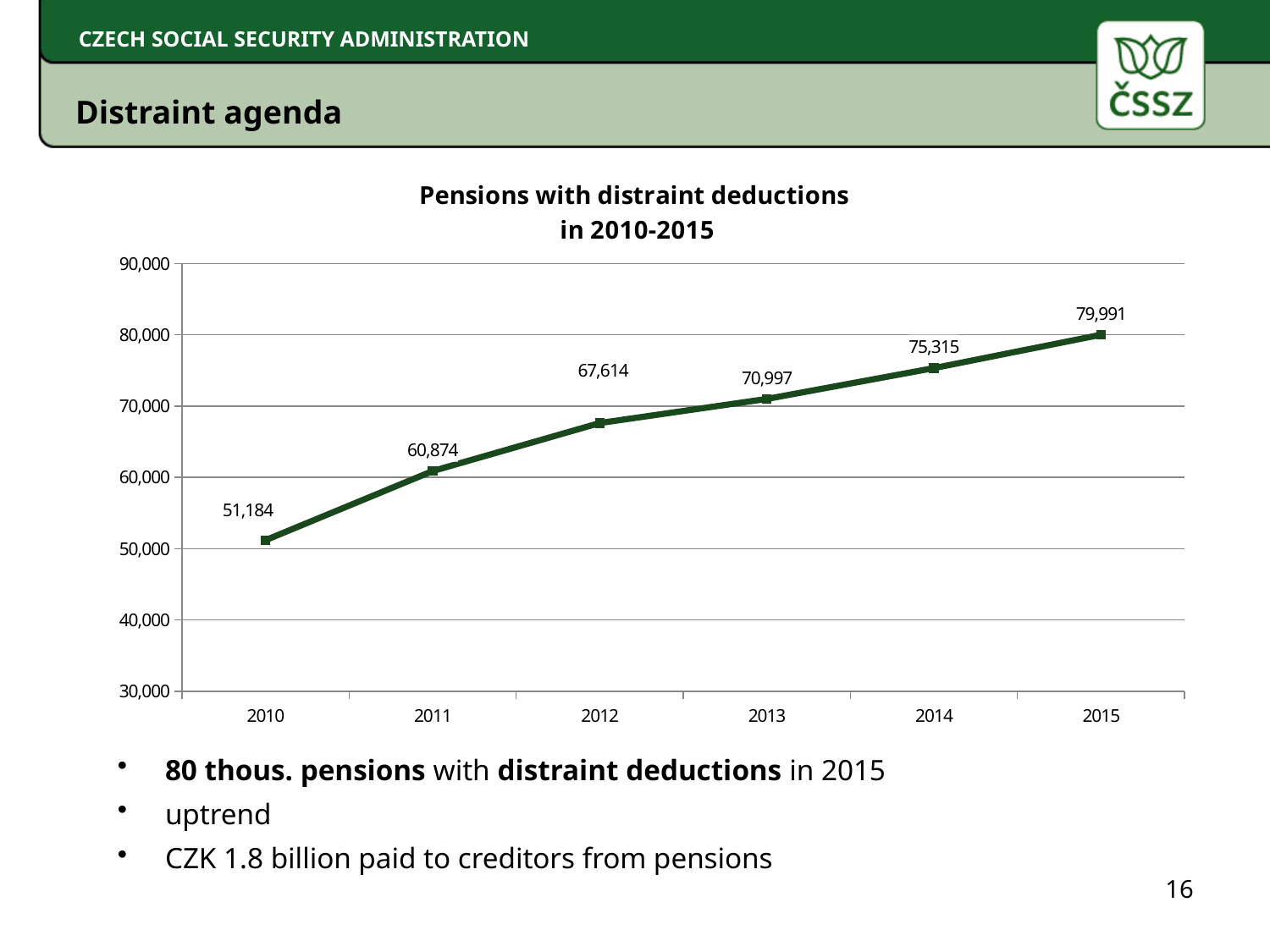
What is the difference between the values for 2012 and 2011? 6,740 What is the difference between the values for 2015 and 2010? 28,807 Which is larger, the value for 2014 or the value for 2012? 2014 Do the values rise or fall from 2010 to 2015? rise What is the value for 2010? 51,184 What is the value for 2013? 70,997 How many years are plotted on the chart? 6 Is the value for 2011 greater or less than 60,000? greater Which year has the highest value? 2015 What kind of chart is shown on the slide? line chart What is the value for 2015? 79,991 Which year has the lowest value? 2010